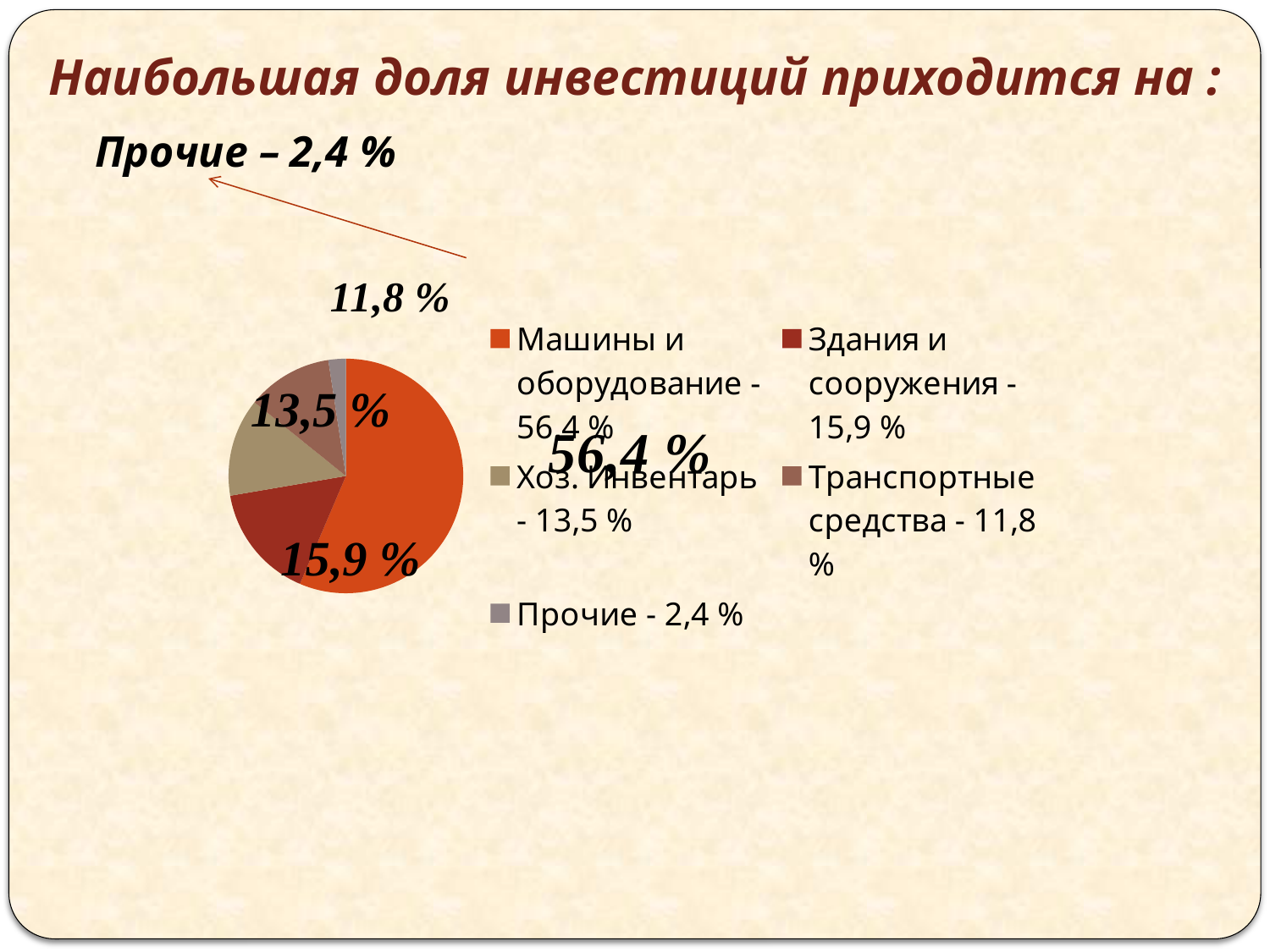
What share of investments goes to Машины и оборудование? 56,4 % How many slices does the pie chart have? 5 What share of investments goes to Здания и сооружения? 15,9 % Which category has the smallest share of investments? Прочие Which is larger: the share for Здания и сооружения or the share for Транспортные средства? Здания и сооружения What share of investments goes to Прочие? 2,4 % Which category has the largest share of investments? Машины и оборудование What share of investments goes to Хоз. инвентарь? 13,5 % What kind of chart is shown on the slide? Pie chart What colour is the slice for Машины и оборудование? Orange-red What is the difference in percentage points between Машины и оборудование and Здания и сооружения? 40,5 What share of investments goes to Транспортные средства? 11,8 %